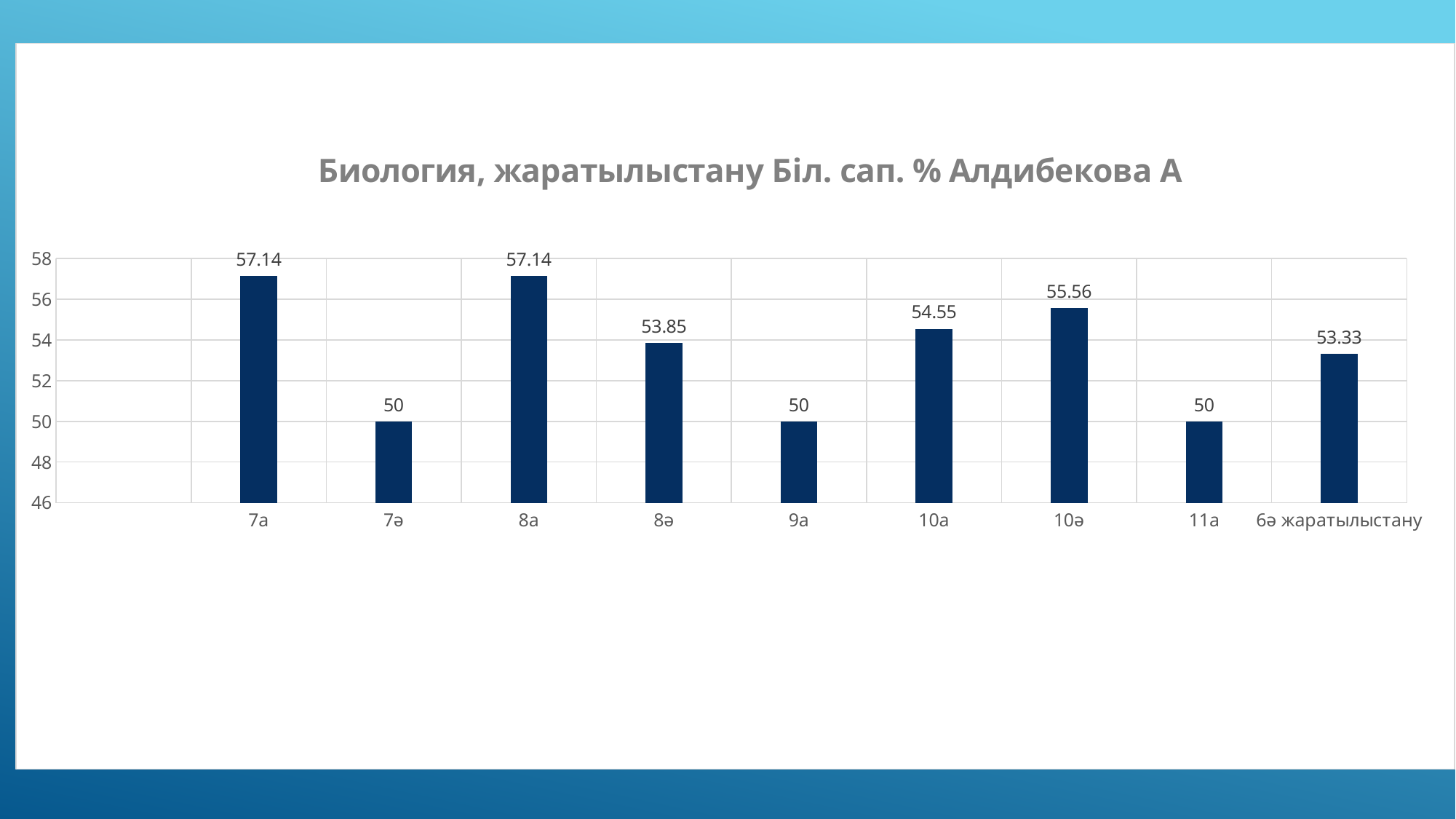
How many categories are shown on the x axis? 9 Is the value for 6ә жаратылыстану greater or less than 52? greater What is the difference between the values for 10ә and 10а? 1.01 What is the value for 10а? 54.55 What is the value for 8ә? 53.85 What is the value for 10ә? 55.56 Which has a larger value, 8ә or 10ә? 10ә What is the value for 6ә жаратылыстану? 53.33 What is the lowest value shown in the chart? 50 What kind of chart is shown on the slide? bar chart What is the highest value shown in the chart? 57.14 What is the difference between the values for 7а and 7ә? 7.14